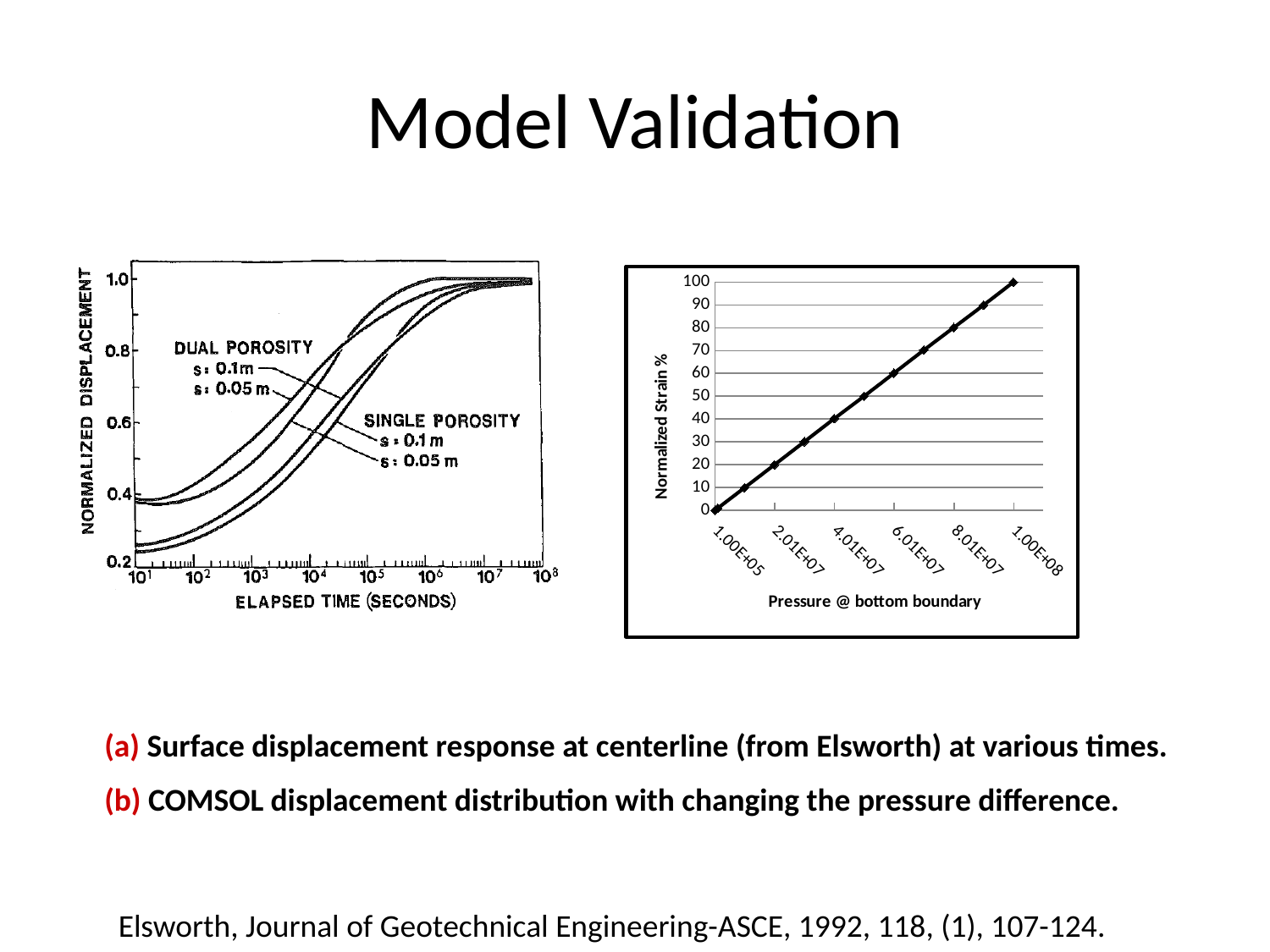
In the right-hand chart, what is the label of the y-axis? Normalized Strain % In the right-hand chart, what is the Normalized Strain % at a pressure of 2.01E+07? 20 What type of chart is the right-hand chart (Normalized Strain % vs Pressure @ bottom boundary)? line chart In the right-hand chart, what is the Normalized Strain % at a pressure of 1.00E+08? 100 In the left-hand chart (Normalized Displacement vs Elapsed Time), how many curves are plotted? 4 In the right-hand chart, what is the Normalized Strain % at a pressure of 1.00E+05? 0 In the left-hand chart, do the curves rise or fall as elapsed time increases? rise In the right-hand chart, how many data points are plotted on the line? 12 In the left-hand chart, is the normalized displacement of the single porosity s = 0.05 m curve at 10^1 seconds greater or less than 0.4? less In the right-hand chart, what is the difference in Normalized Strain % between pressures 8.01E+07 and 4.01E+07? 40 In the right-hand chart, does Normalized Strain % rise or fall as the pressure at the bottom boundary increases? rise In the right-hand chart, what is the Normalized Strain % at a pressure of 6.01E+07? 60